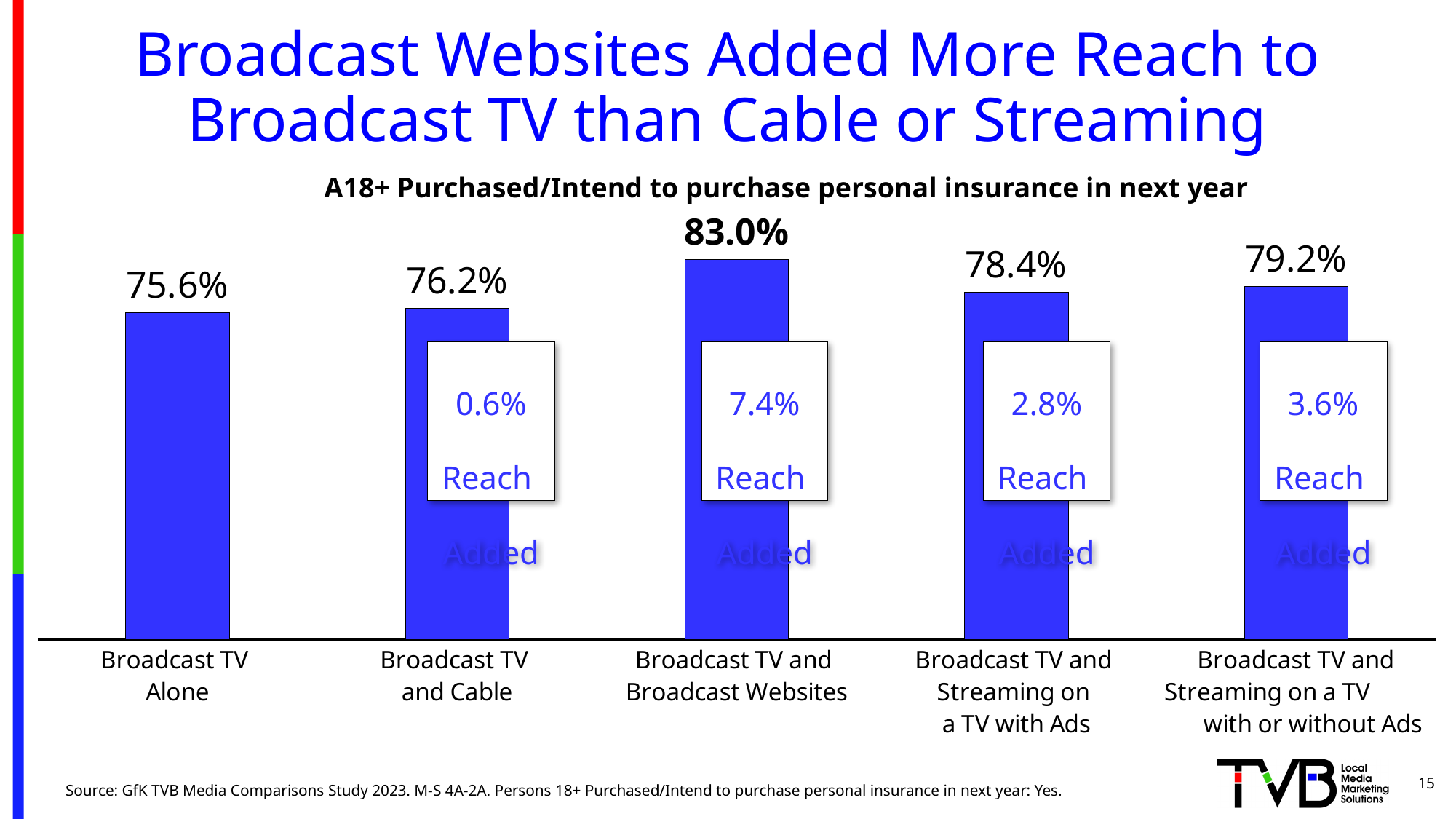
How many categories are shown in the chart? 5 How much reach is added by Broadcast TV and Streaming on a TV with or without Ads compared to Broadcast TV Alone, according to the label on the bar? 3.6% What kind of chart is shown on the slide? Bar chart What is the subtitle of the chart? A18+ Purchased/Intend to purchase personal insurance in next year Which is larger: Broadcast TV and Streaming on a TV with Ads or Broadcast TV and Streaming on a TV with or without Ads? Broadcast TV and Streaming on a TV with or without Ads What is the value for Broadcast TV Alone? 75.6% Which category has the lowest value? Broadcast TV Alone What is the value for Broadcast TV and Cable? 76.2% What is the difference between Broadcast TV and Broadcast Websites and Broadcast TV Alone? 7.4% What is the value for Broadcast TV and Broadcast Websites? 83.0% What is the value for Broadcast TV and Streaming on a TV with Ads? 78.4% Which category has the highest value? Broadcast TV and Broadcast Websites